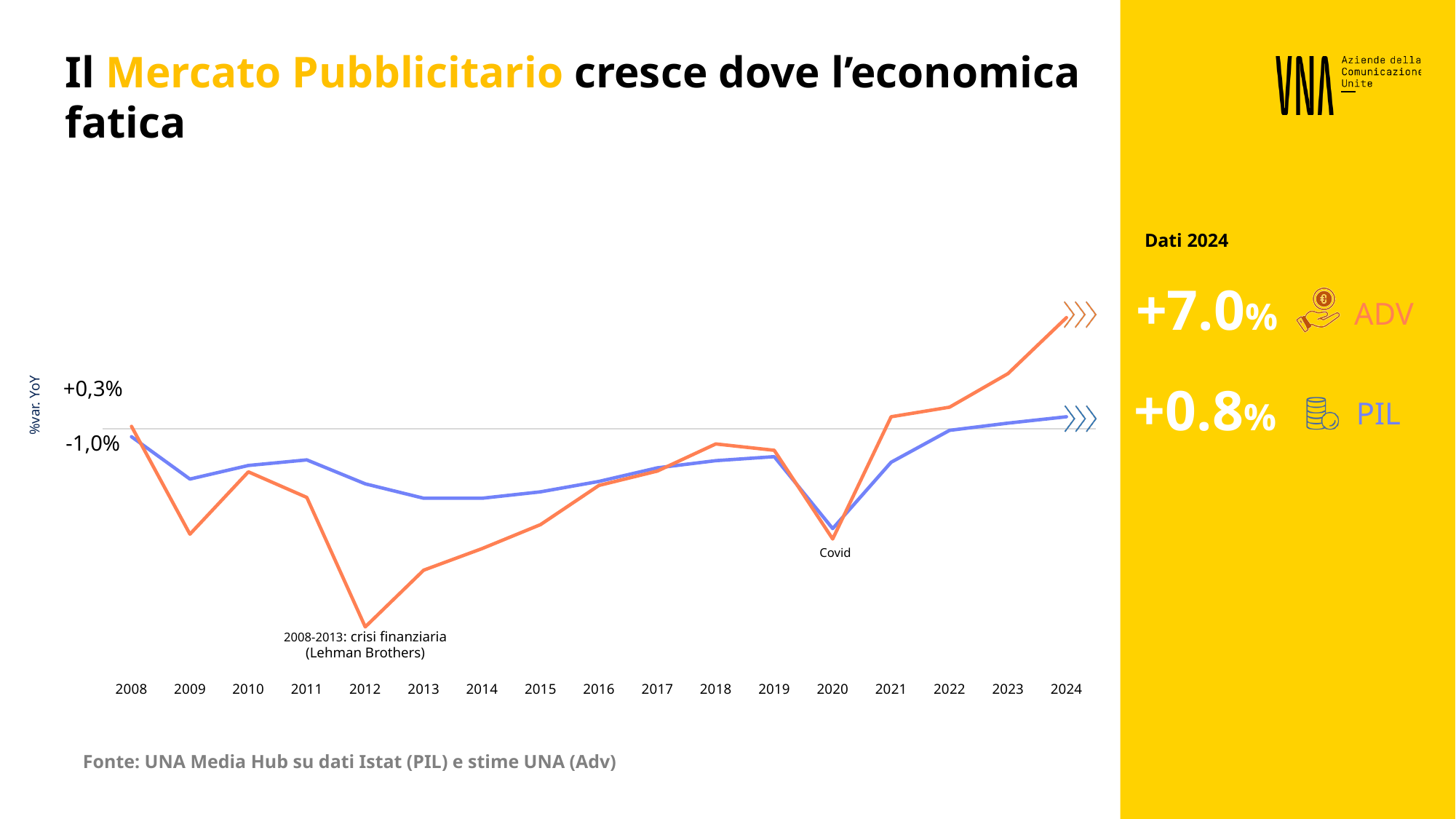
What is the difference between the ADV and PIL values in 2024? 6.2 percentage points In 2024, which is larger, the ADV value or the PIL value? ADV What is the ADV value for 2024? +7.0% In which year does the PIL line reach its lowest point? 2020 What is the PIL value for 2024? +0.8% What is the ADV value for 2008? +0,3% What event is annotated on the chart at 2020? Covid In which year does the ADV line reach its lowest point? 2012 How many lines (series) are plotted on the chart? 2 What is the PIL value for 2008? -1,0% What kind of chart is shown on the slide? Line chart How many years are shown on the x axis of the chart? 17